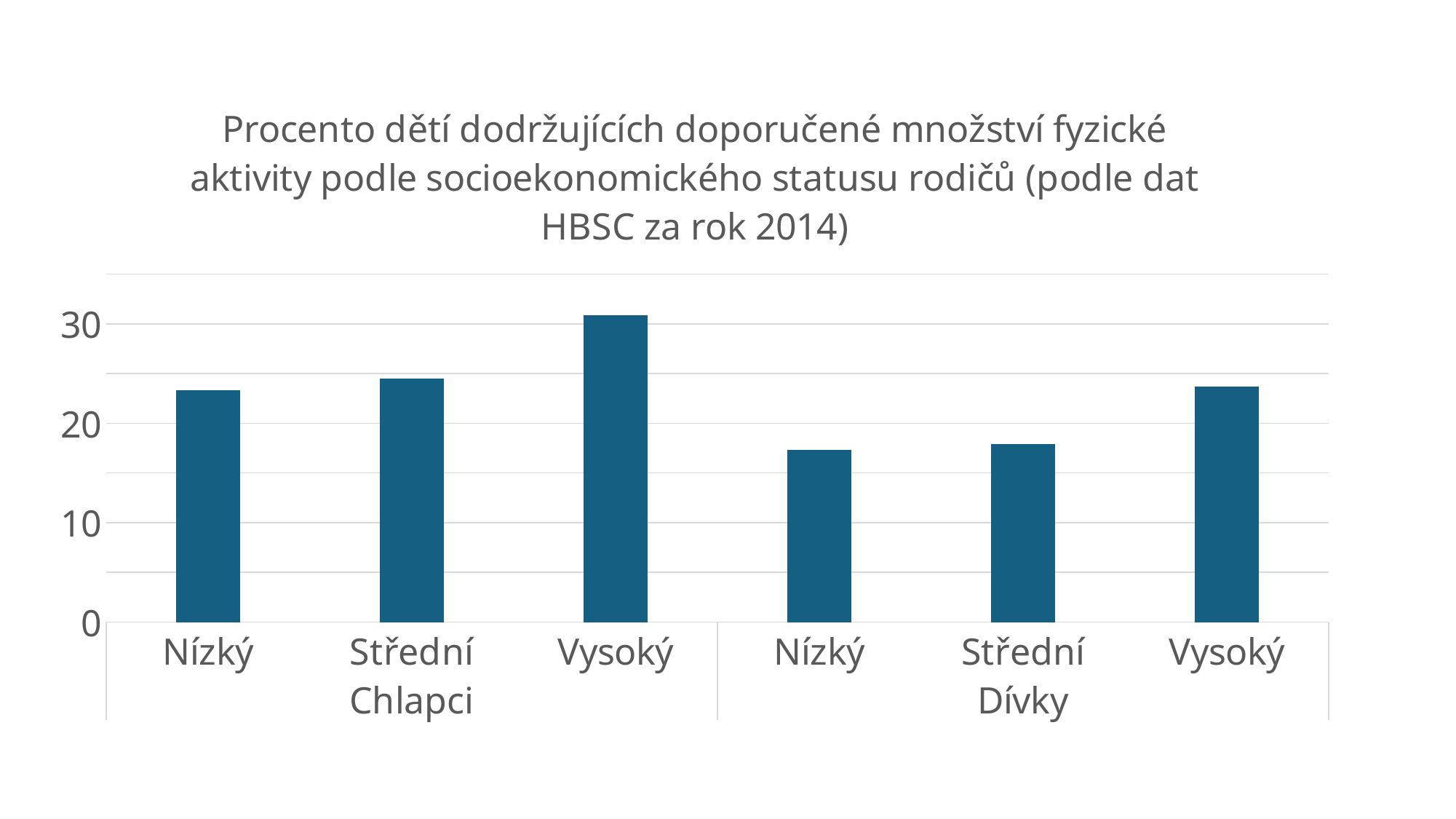
Within the Chlapci group, do the values rise or fall from Nízký to Vysoký? rise Which bar has the highest value in the chart? Vysoký (Chlapci) How many bars are plotted in the chart? 6 Is the value for Střední in the Dívky group greater or less than 20? less Which year of HBSC data does the chart title refer to? 2014 Is the value for Nízký in the Chlapci group greater or less than 20? greater Is the value for Vysoký in the Chlapci group greater or less than 30? greater What kind of chart is shown on the slide? bar chart Which is larger: the value for Nízký among Chlapci or Nízký among Dívky? Nízký among Chlapci Which is larger: the value for Vysoký among Chlapci or Vysoký among Dívky? Vysoký among Chlapci